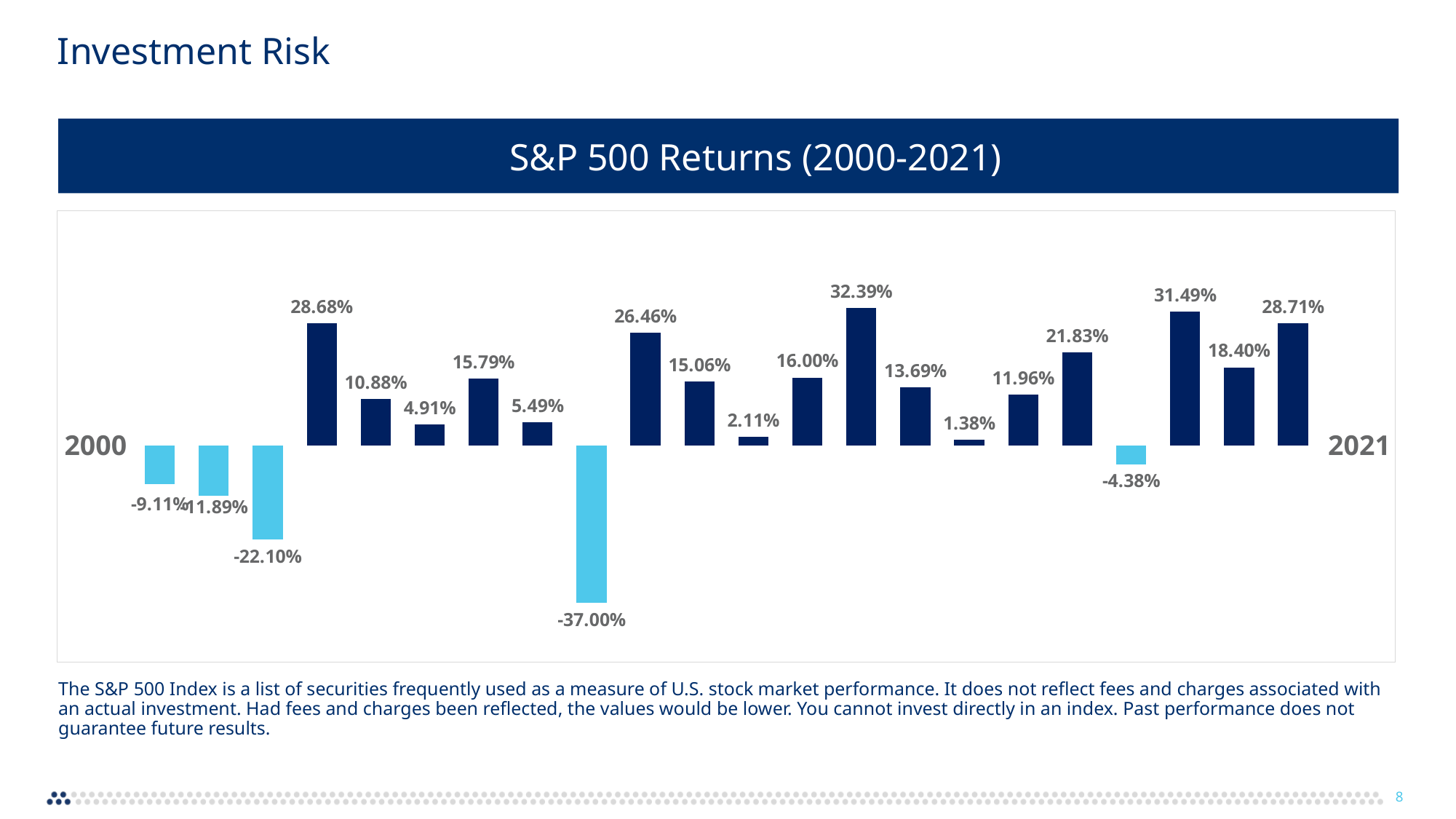
How many years in the S&P 500 Returns chart show a negative return? 5 What is the difference between the 2021 return (28.71%) and the 2000 return (-9.11%)? 37.82 percentage points What is the difference between the highest return (32.39%) and the lowest return (-37.00%) in the chart? 69.39 percentage points What is the S&P 500 return shown for 2021, the last bar in the chart? 28.71% What colour are the bars for years with negative returns in the S&P 500 Returns chart? light blue What is the S&P 500 return shown for 2000, the first bar in the chart? -9.11% What is the highest annual return shown in the S&P 500 Returns chart? 32.39% How many years in the S&P 500 Returns chart show a return above 30%? 2 What is the lowest annual return shown in the S&P 500 Returns chart? -37.00% What kind of chart is used to show the S&P 500 Returns (2000-2021)? bar chart How many yearly bars are plotted in the S&P 500 Returns (2000-2021) chart? 22 Which year has the larger S&P 500 return, 2000 or 2021? 2021